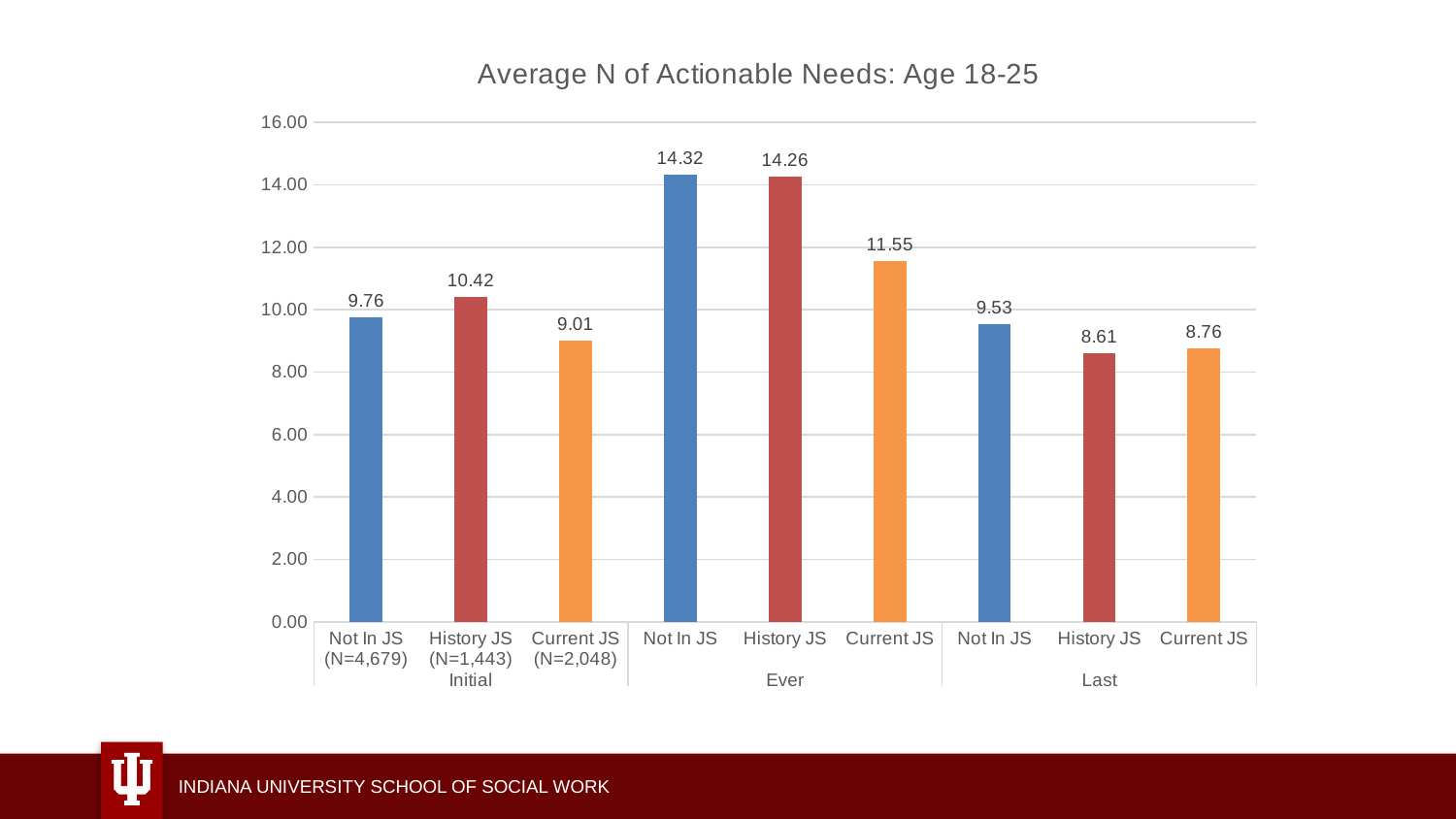
What is the value for Current JS in the Last group? 8.76 How many bars are plotted on the chart? 9 What is the value for Not In JS in the Ever group? 14.32 What is the difference between Not In JS and Current JS in the Ever group? 2.77 What is the difference between History JS and Current JS in the Initial group? 1.41 Is the value for Current JS in the Ever group greater or less than 12.00? less Which bar has the lowest value on the chart? History JS (Last) Which bar has the highest value on the chart? Not In JS (Ever) Which is larger: Not In JS in the Initial group or Not In JS in the Last group? Not In JS in the Initial group What kind of chart is shown on the slide? Bar chart What is the title of the chart? Average N of Actionable Needs: Age 18-25 What is the value for History JS in the Initial group? 10.42